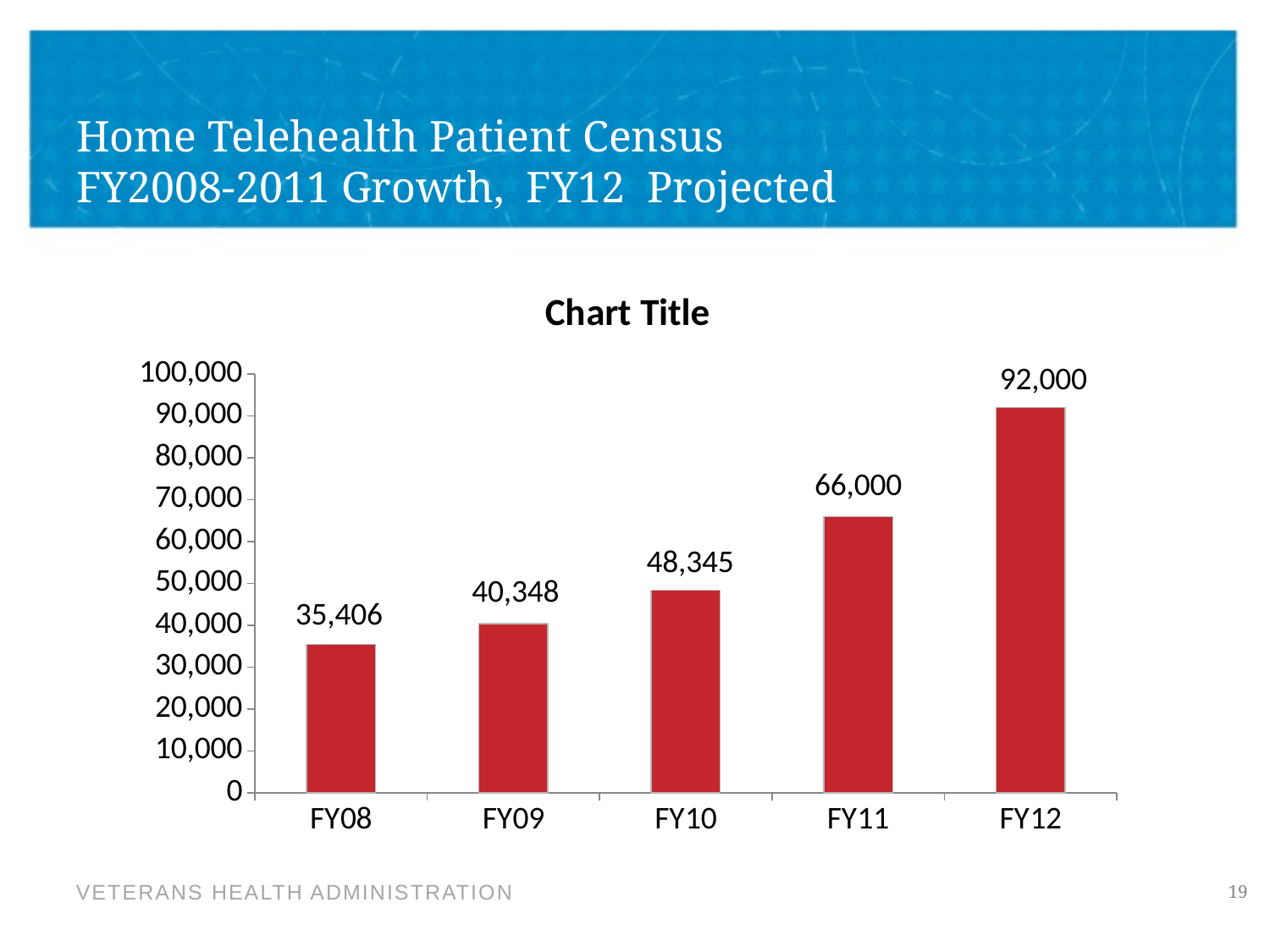
What is the difference between the FY12 and FY11 values? 26,000 What is the difference between the FY09 and FY08 values? 4,942 Which fiscal year has the highest value? FY12 Do the values rise or fall from FY08 to FY12? Rise What is the value for FY10? 48,345 Is the value for FY11 greater or less than 60,000? greater What is the value for FY12? 92,000 What is the value for FY08? 35,406 Which fiscal year has the lowest value? FY08 Which is larger, the value for FY10 or the value for FY11? FY11 How many fiscal years are shown on the x axis? 5 What kind of chart is shown on the slide? Bar chart